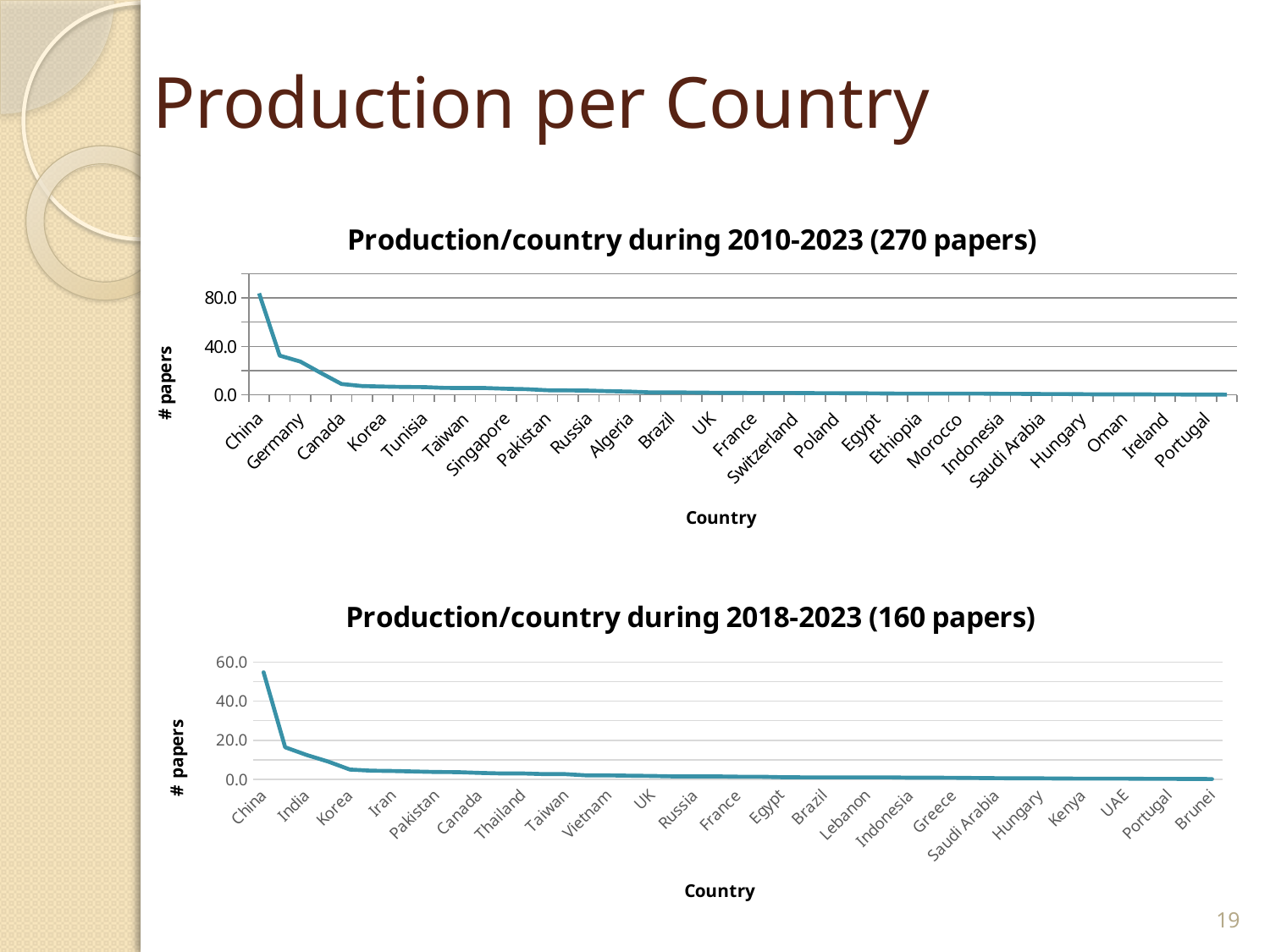
In the 'Production/country during 2010-2023 (270 papers)' chart, is the value for Germany greater or less than 40.0? less In the 'Production/country during 2018-2023 (160 papers)' chart, which has more papers, India or Korea? India In the 'Production/country during 2010-2023 (270 papers)' chart, which country has the highest number of papers? China In the 'Production/country during 2010-2023 (270 papers)' chart, is the value for China greater or less than 40.0? greater In the 'Production/country during 2018-2023 (160 papers)' chart, do the values rise or fall from left to right along the x axis? fall In the 'Production/country during 2018-2023 (160 papers)' chart, is the value for China greater or less than 40.0? greater In the 'Production/country during 2010-2023 (270 papers)' chart, which has more papers, China or Canada? China What kind of chart is the 'Production/country during 2010-2023 (270 papers)' chart? line chart In the 'Production/country during 2018-2023 (160 papers)' chart, which country has the highest number of papers? China In the 'Production/country during 2010-2023 (270 papers)' chart, do the values rise or fall from left to right along the x axis? fall What is the y-axis label of the 'Production/country during 2018-2023 (160 papers)' chart? # papers